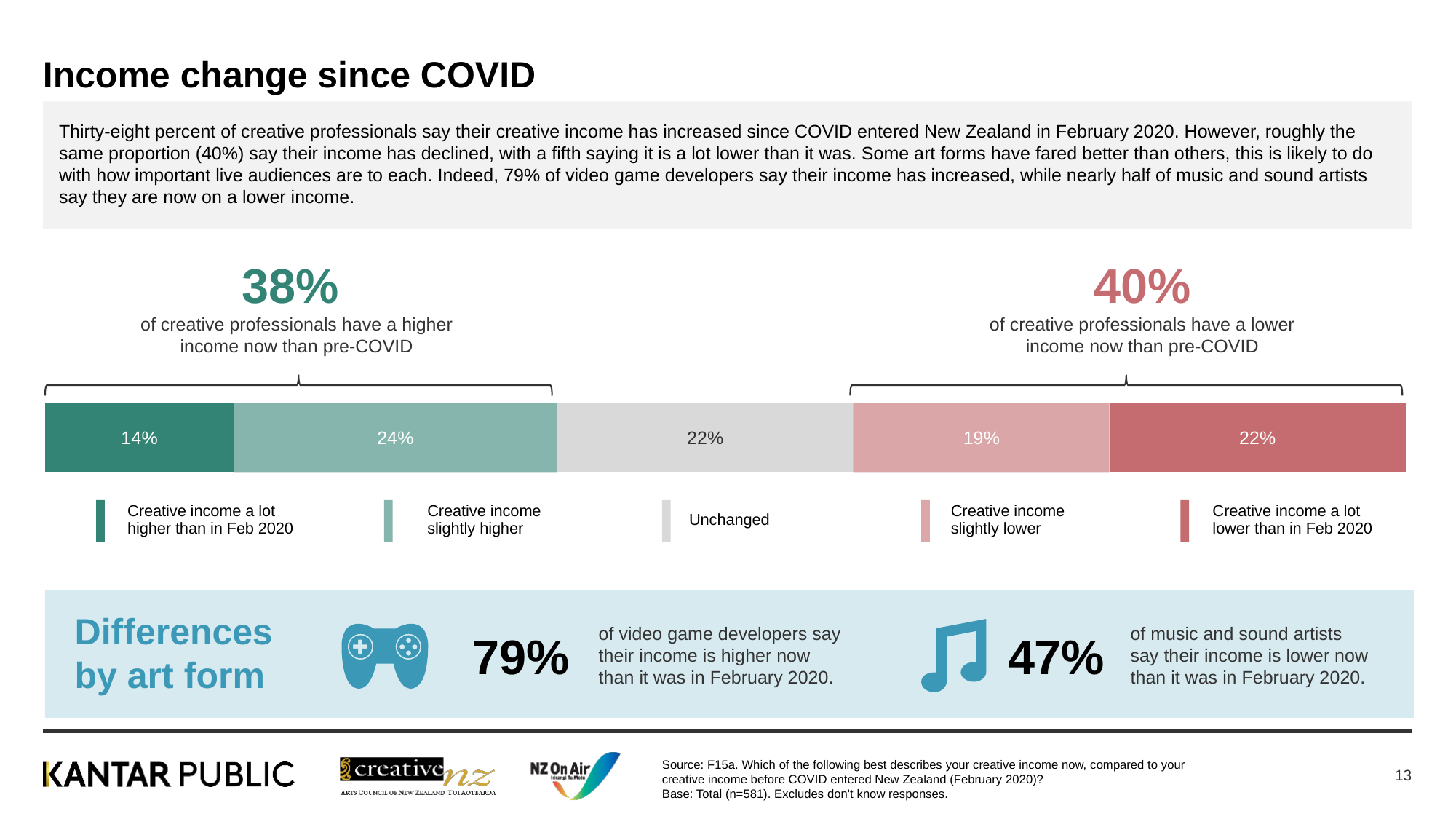
Which response category has the lowest percentage in the stacked bar? Creative income a lot higher than in Feb 2020 What is the combined percentage of creative professionals who say their income is lower now than pre-COVID? 40% What percentage of creative professionals say their creative income is a lot higher than in Feb 2020? 14% How many segments does the stacked bar contain? 5 Which is larger: the percentage saying income is slightly lower or the percentage saying income is a lot lower than in Feb 2020? Creative income a lot lower than in Feb 2020 What percentage of creative professionals say their creative income is slightly higher? 24% What percentage of creative professionals say their creative income is unchanged? 22% What colour is the segment for 'Unchanged' in the stacked bar? Grey What kind of chart is shown on the slide? Stacked bar chart What percentage of creative professionals say their creative income is slightly lower? 19% What is the difference between the percentage saying income is slightly higher and the percentage saying income is a lot higher than in Feb 2020? 10 percentage points Which response category has the highest percentage in the stacked bar? Creative income slightly higher